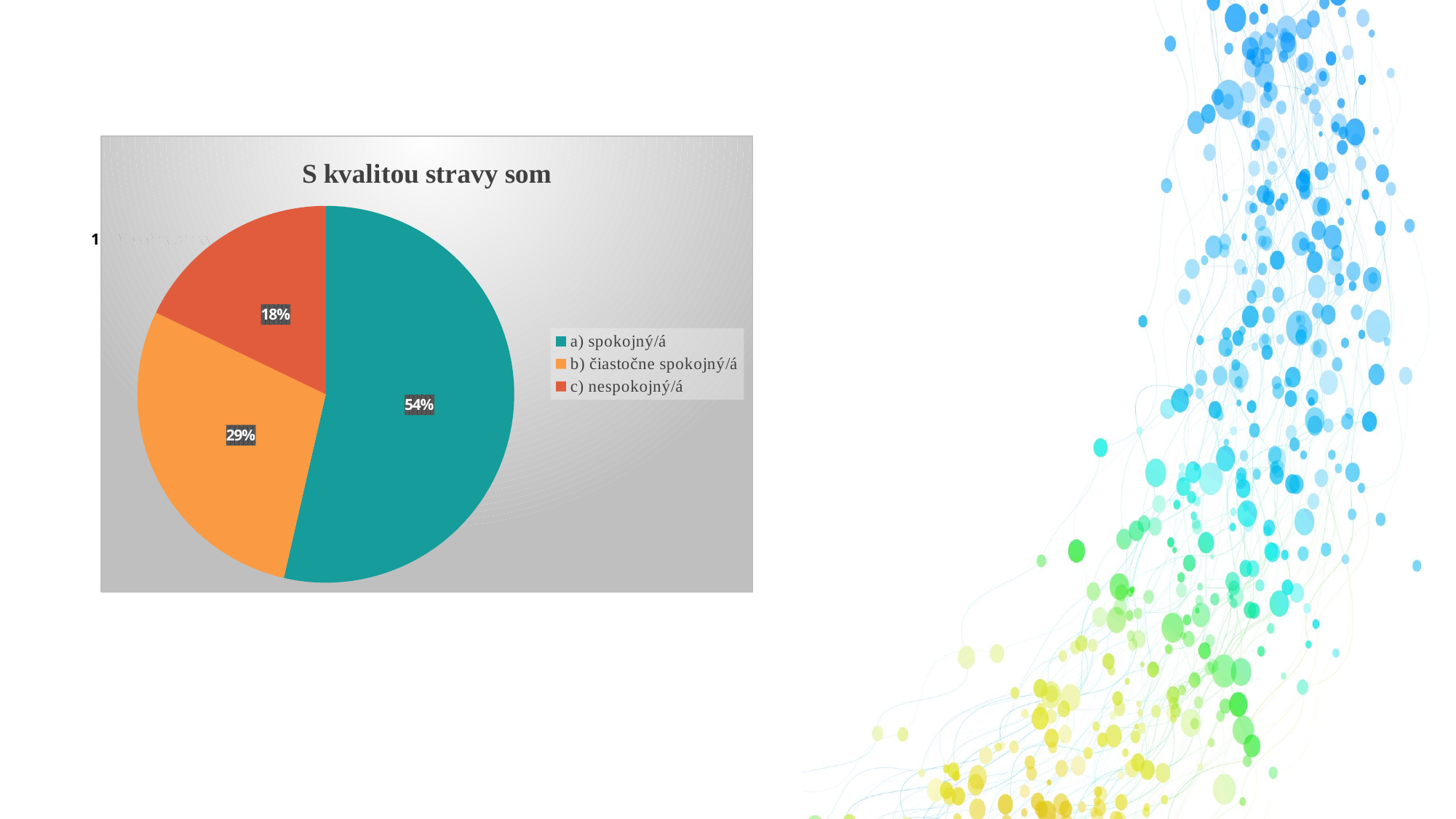
What is the title of the chart? S kvalitou stravy som What kind of chart is shown on the slide? pie chart What share of the pie does "b) čiastočne spokojný/á" take? 29% How many entries does the legend list? 3 Which is larger, the slice for "b) čiastočne spokojný/á" or the slice for "c) nespokojný/á"? b) čiastočne spokojný/á What is the difference in percentage points between "a) spokojný/á" and "b) čiastočne spokojný/á"? 25 What share of the pie does "a) spokojný/á" take? 54% How many slices does the pie chart have? 3 Which category has the smallest slice of the pie? c) nespokojný/á What colour is the slice for "c) nespokojný/á"? red What share of the pie does "c) nespokojný/á" take? 18% Which category has the largest slice of the pie? a) spokojný/á